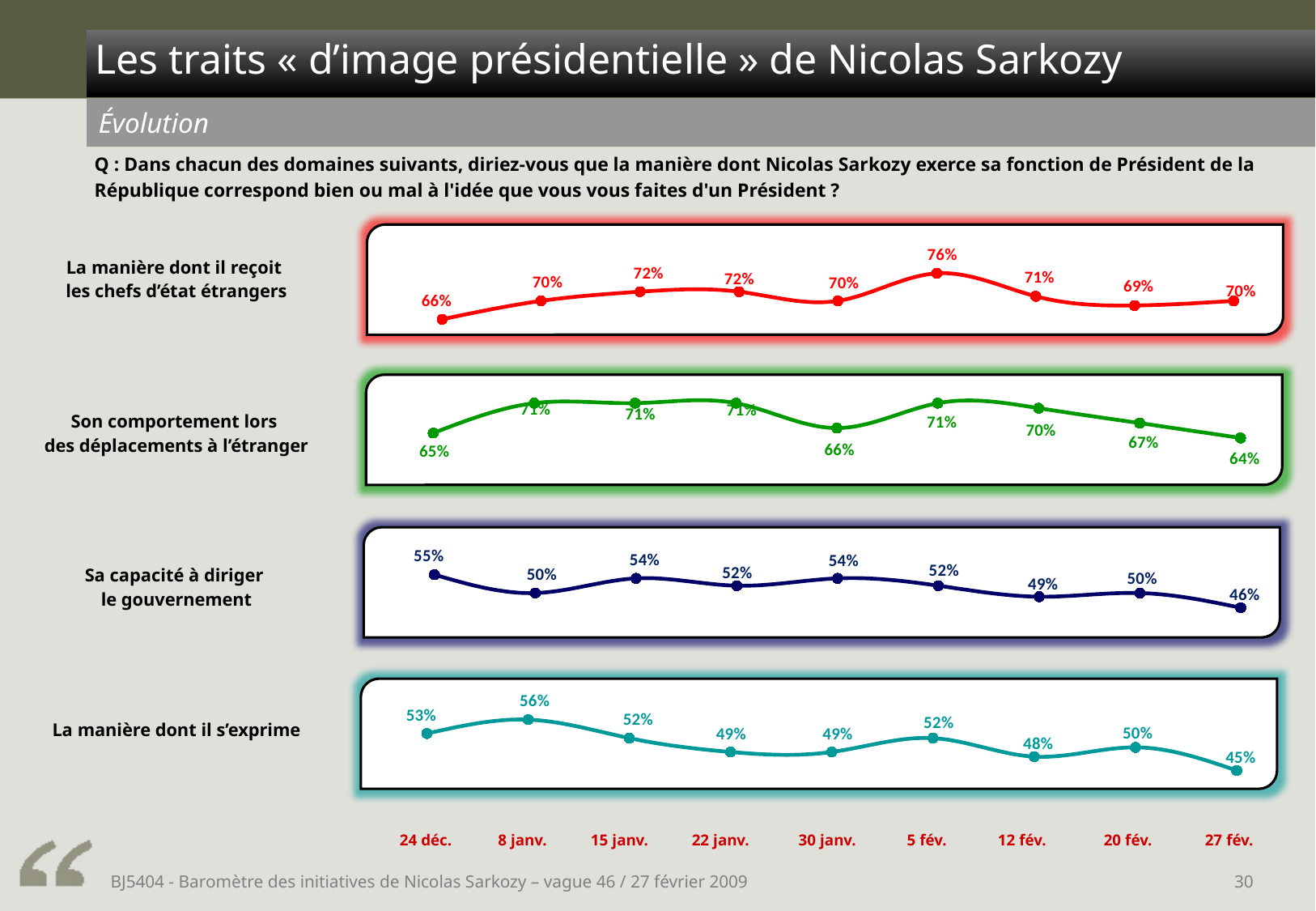
In the chart 'La manière dont il s'exprime', which is larger, the value for 8 janv. or the value for 27 fév.? 8 janv. In the chart 'Sa capacité à diriger le gouvernement', what is the value for 12 fév.? 49% In the chart 'Son comportement lors des déplacements à l'étranger', what is the value for 27 fév.? 64% In the chart 'La manière dont il reçoit les chefs d'état étrangers', which date has the lowest value? 24 déc. In the chart 'Son comportement lors des déplacements à l'étranger', what is the difference between the values for 24 déc. and 8 janv.? 6 percentage points In the chart 'La manière dont il reçoit les chefs d'état étrangers', what is the value for 5 fév.? 76% What type of chart is used for 'Sa capacité à diriger le gouvernement'? Line chart In the chart 'Sa capacité à diriger le gouvernement', do the values overall rise or fall from 24 déc. to 27 fév.? Fall In the chart 'La manière dont il s'exprime', what is the difference between the values for 8 janv. and 27 fév.? 11 percentage points What colour is the line in the chart 'Son comportement lors des déplacements à l'étranger'? Green In the chart 'Sa capacité à diriger le gouvernement', which date has the highest value? 24 déc. How many data points are plotted in the chart 'La manière dont il s'exprime'? 9